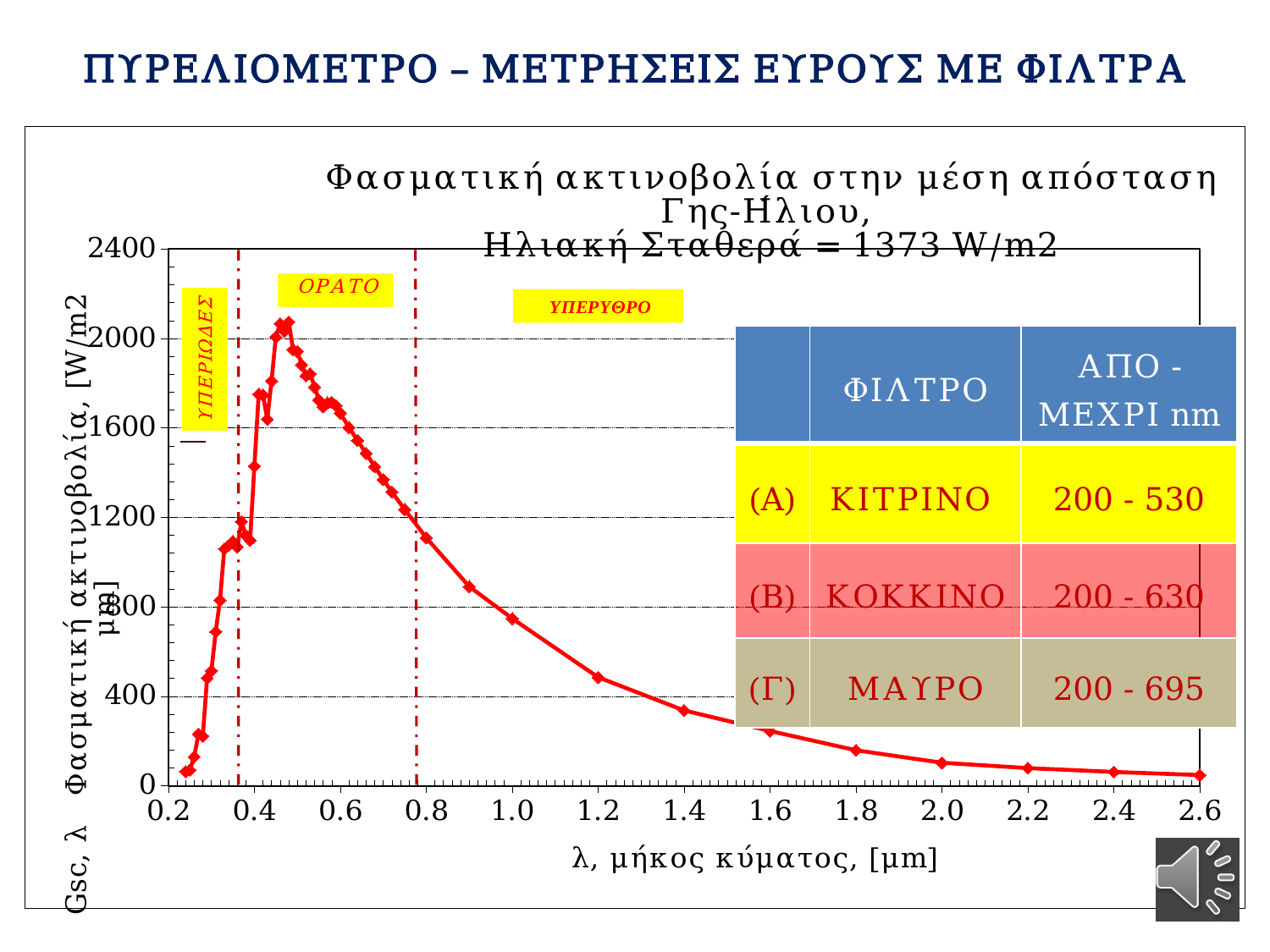
Is the value of the curve at a wavelength of 0.8 μm greater or less than 1200? less Do the values of the curve rise or fall as the wavelength increases from 1.0 μm to 2.6 μm? fall What is the highest tick value shown on the y axis? 2400 Is the value of the curve at a wavelength of 1.0 μm greater or less than 800? less Is the value of the curve at a wavelength of 1.6 μm greater or less than 400? less What is the label of the x axis of the chart? λ, μήκος κύματος, [μm] What kind of chart is shown on the slide? line chart What is the title of the chart? Φασματική ακτινοβολία στην μέση απόσταση Γης-Ηλιου, Ηλιακή Σταθερά = 1373 W/m2 Which is larger, the value of the curve at 1.0 μm or at 2.0 μm? 1.0 μm